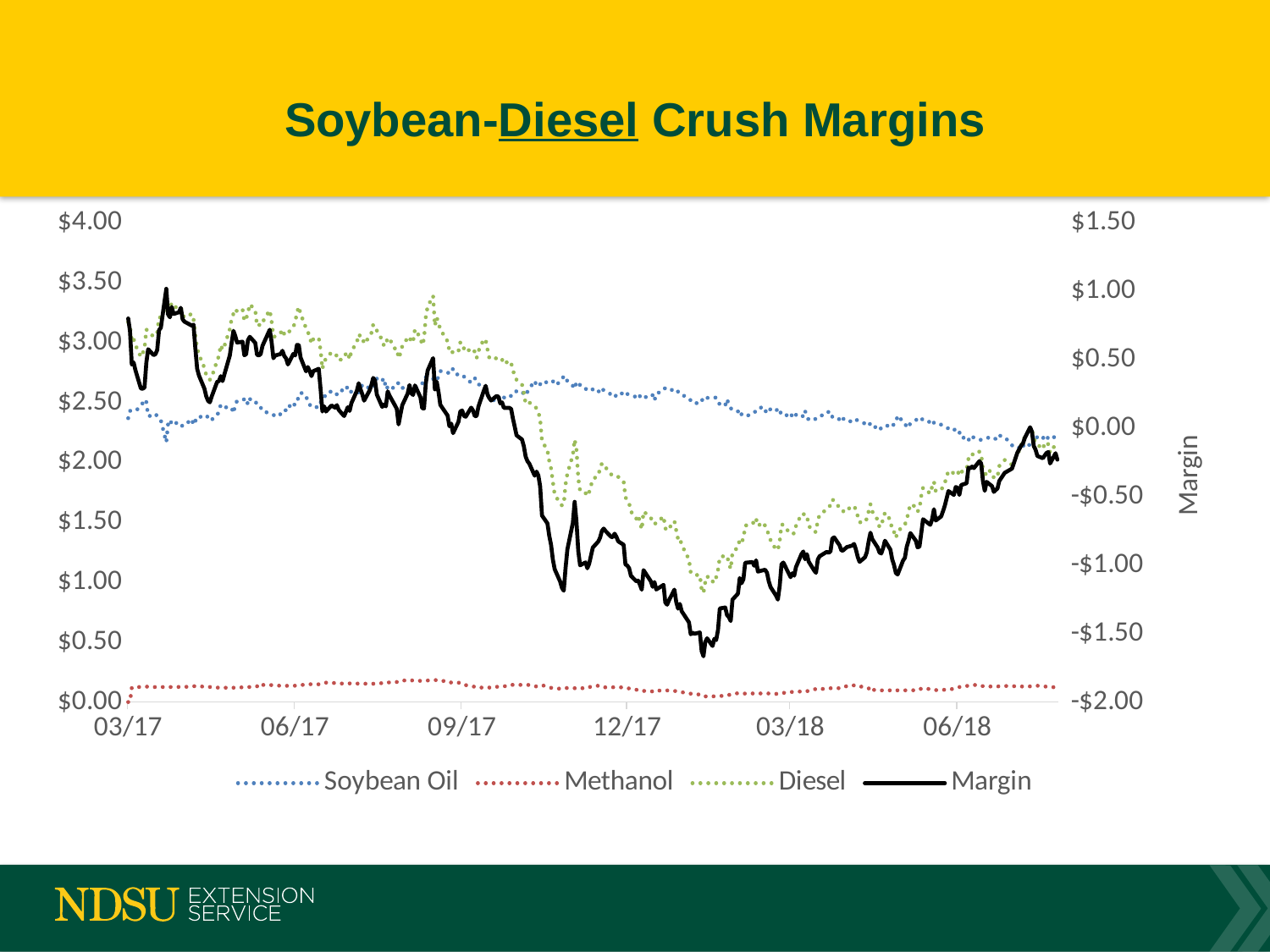
Does the Soybean Oil line rise or fall between 12/17 and 06/18? fall What kind of chart is shown on the slide? Line chart Is the value for Diesel at 03/18 greater or less than $2.00? less At 03/18, which is higher, Soybean Oil or Diesel? Soybean Oil How many series does the legend list? 4 How many date labels are shown along the x axis? 6 Is the value for Soybean Oil at 03/18 greater or less than $2.00? greater At 06/17, which is higher, Diesel or Soybean Oil? Diesel Is the value for Methanol at 09/17 greater or less than $0.50? less What is the label on the right-hand vertical axis? Margin What is the title of the chart? Soybean-Diesel Crush Margins